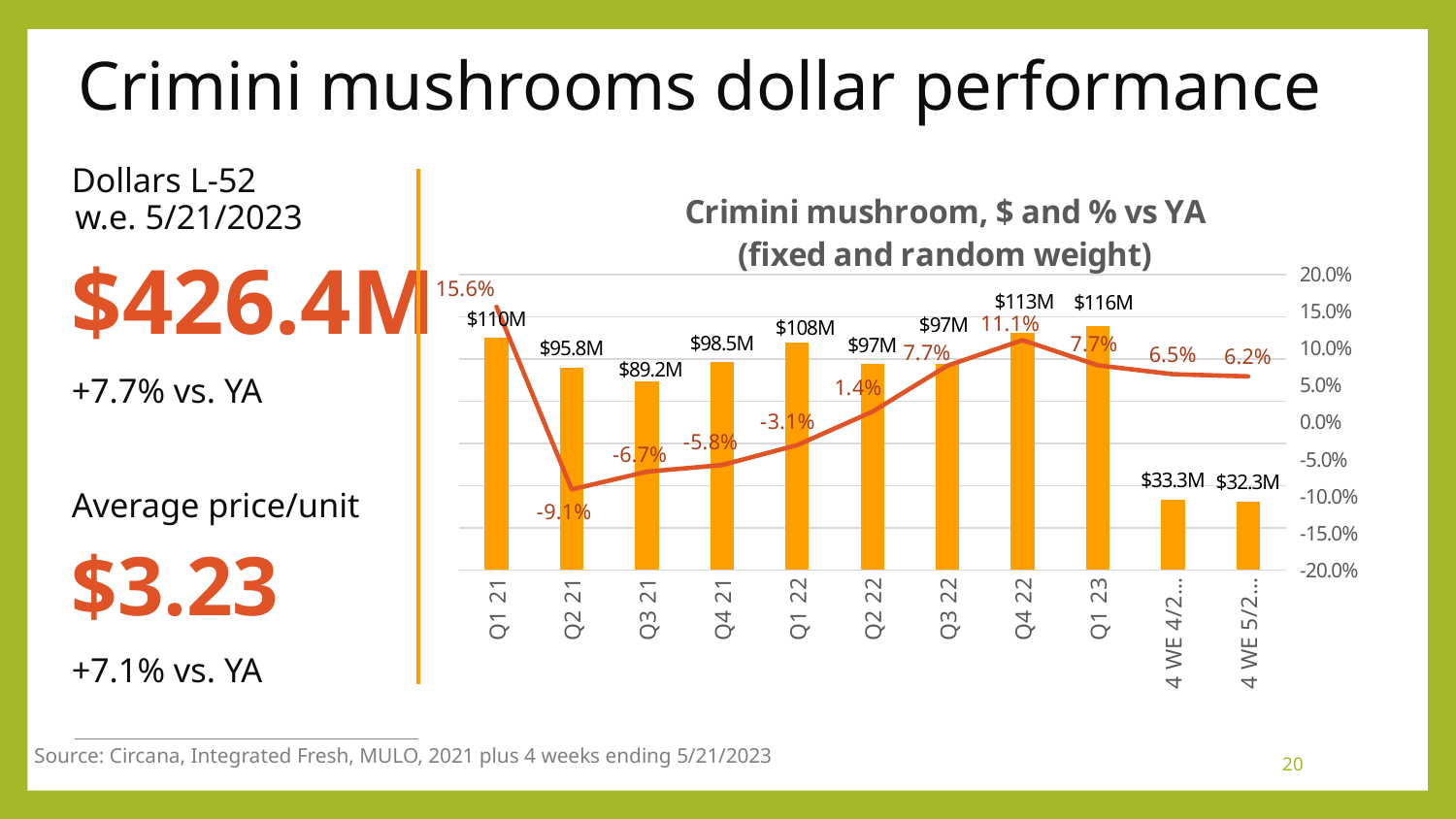
Which quarter has the highest dollar value? Q1 23 Which period has the lowest % vs YA value? Q2 21 What is the difference in dollars between Q4 22 and Q1 23? $3M What is the dollar value for Q3 21? $89.2M What is the dollar value for Q1 23? $116M What kind of chart is this? Combination bar and line chart What is the title of the chart? Crimini mushroom, $ and % vs YA (fixed and random weight) How many periods are shown on the x axis? 11 Does the % vs YA line rise or fall from Q2 21 to Q4 22? Rise Is the % vs YA value for Q4 22 greater or less than 10.0%? greater What is the % vs YA value for Q2 21? -9.1% Which is larger, the dollar value for Q1 21 or Q1 22? Q1 21